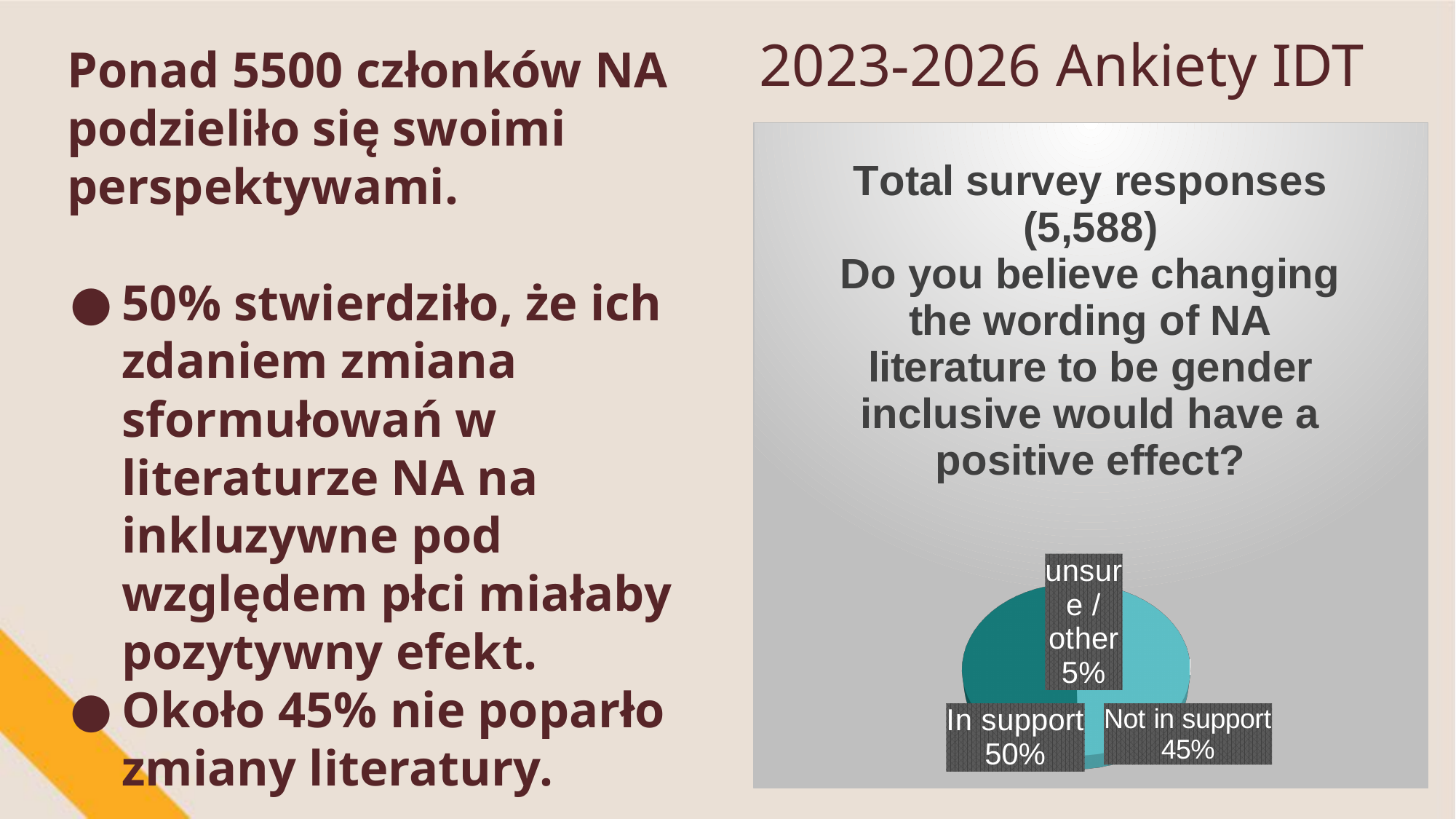
Which is larger, the "Not in support" slice or the "unsure / other" slice? Not in support Which slice of the pie chart is the smallest? unsure / other How many slices does the pie chart have? 3 What kind of chart is shown on the slide? pie chart Which slice of the pie chart is the largest? In support What share of responses is labelled "In support"? 50% What is the difference in percentage points between "In support" and "Not in support"? 5 What share of responses is labelled "Not in support"? 45% What is the difference in percentage points between "In support" and "unsure / other"? 45 What is the total number of survey responses stated in the chart title? 5,588 What share of responses is labelled "unsure / other"? 5%